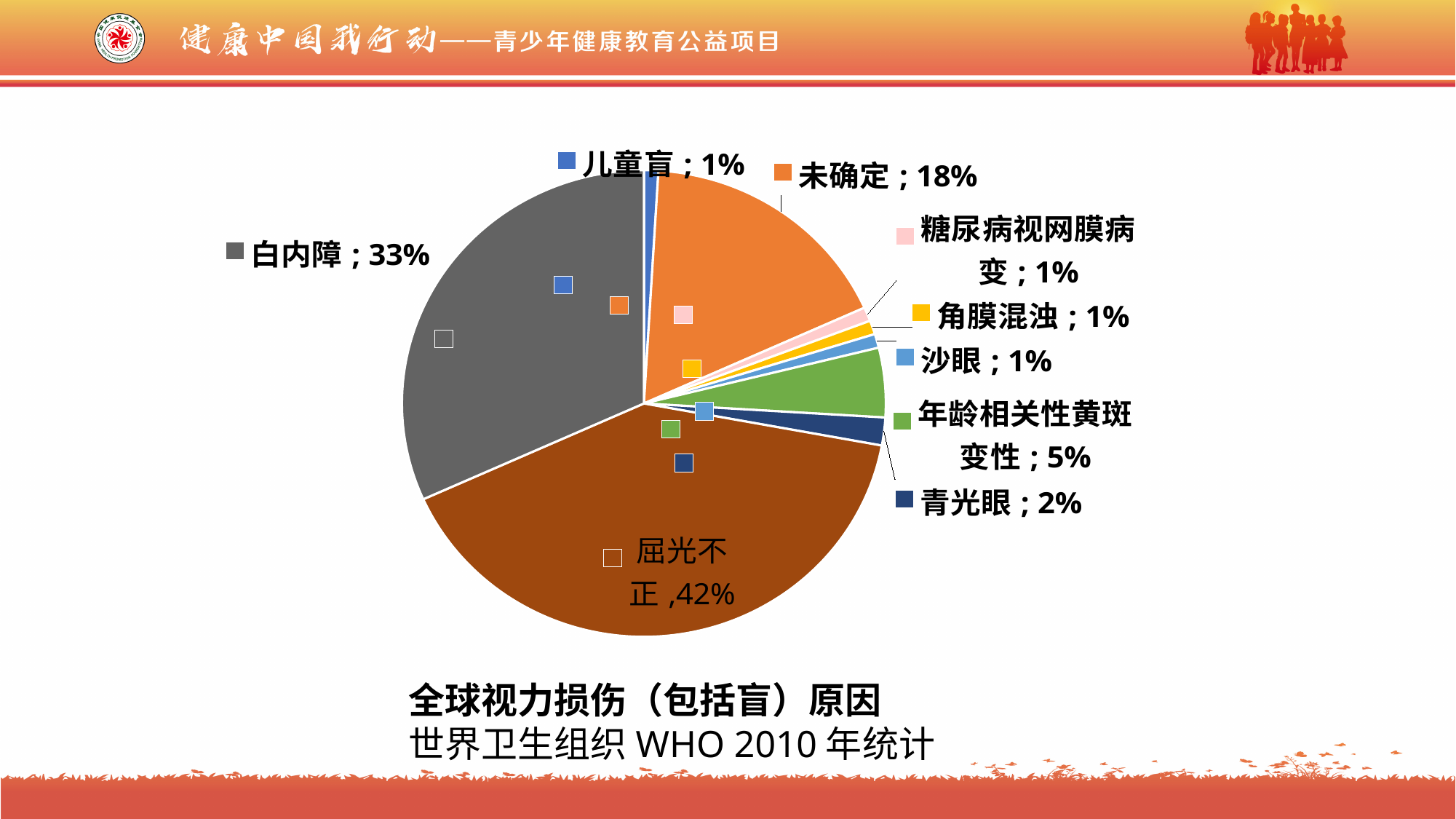
What share of the pie does 屈光不正 account for? 42% What is the value shown for 青光眼? 2% What is the title of the chart? 全球视力损伤（包括盲）原因 Which category has the largest slice of the pie? 屈光不正 What is the value shown for 白内障? 33% What is the value shown for 年龄相关性黄斑变性? 5% What is the difference between the values for 屈光不正 and 白内障? 9% Which is larger, the value for 未确定 or the value for 年龄相关性黄斑变性? 未确定 What kind of chart is shown on the slide? pie chart What is the difference between the values for 年龄相关性黄斑变性 and 青光眼? 3% What is the value shown for 未确定? 18% How many slices does the pie chart have? 9